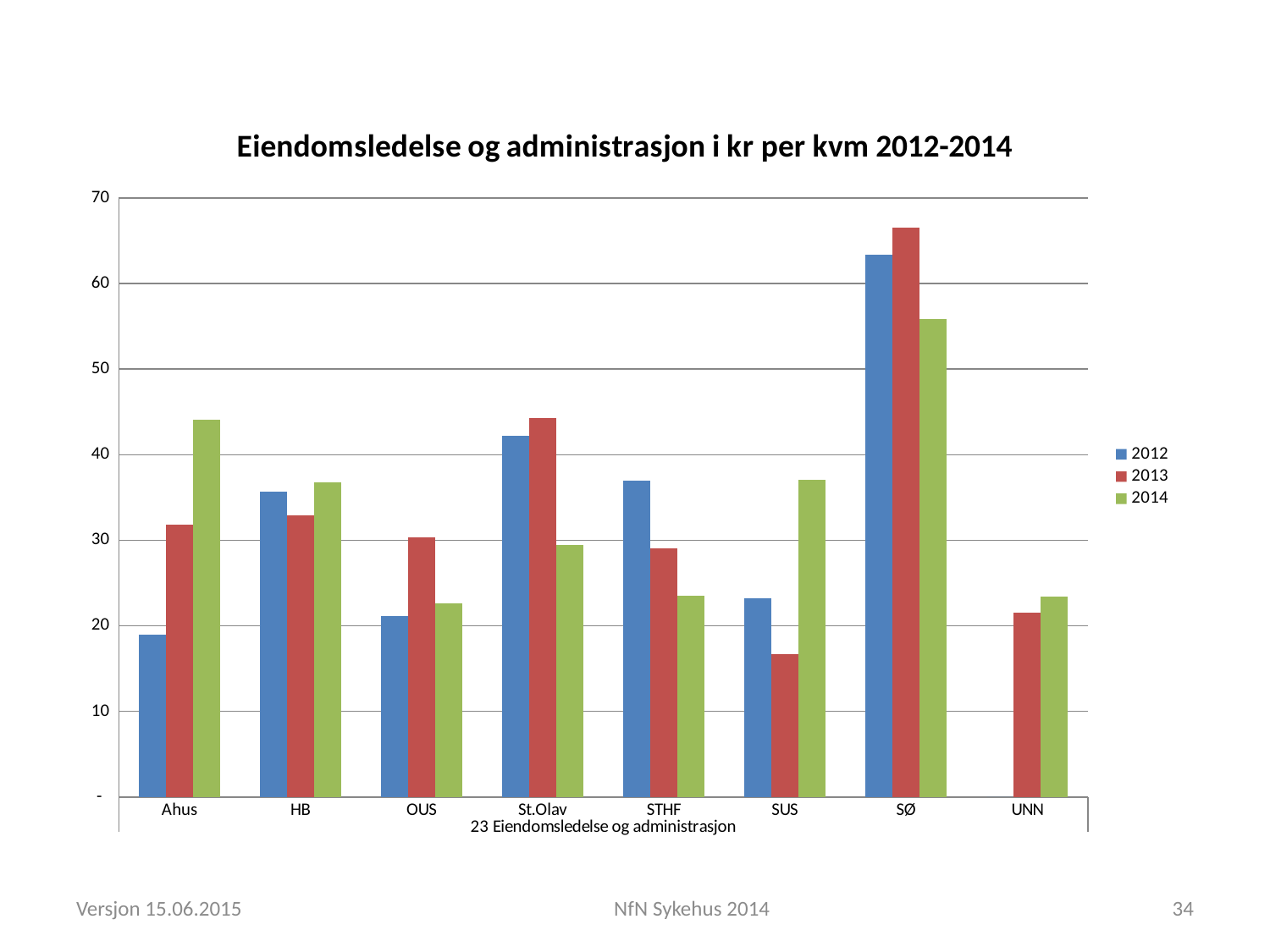
For STHF, which year has the larger value, 2012 or 2013? 2012 Which category has the highest value for 2013? SØ How many series does the legend list? 3 Is the value for Ahus in 2014 greater or less than 40? greater Which category has the lowest value for 2013? SUS How many categories are shown on the x axis? 8 Which category has no bar for 2012? UNN For Ahus, which year has the larger value, 2012 or 2014? 2014 What kind of chart is shown on the slide? bar chart Is the value for SUS in 2013 greater or less than 20? less Do the values for Ahus rise or fall from 2012 to 2014? rise Is the value for SØ in 2014 greater or less than 50? greater